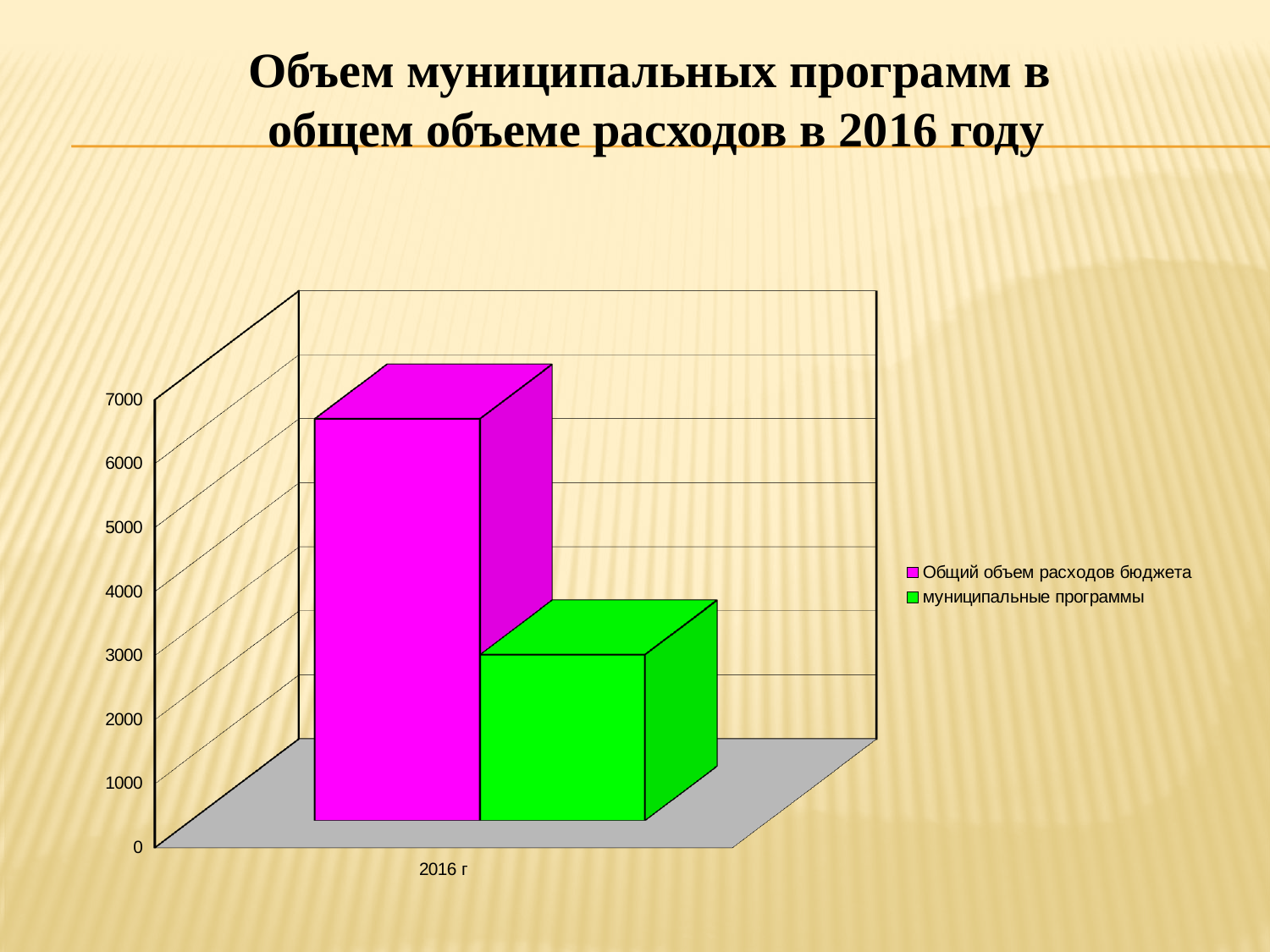
Which series has the taller bar, Общий объем расходов бюджета or муниципальные программы? Общий объем расходов бюджета What colour is the bar for муниципальные программы? green Is the value for муниципальные программы greater or less than 4000? less What kind of chart is shown on the slide? bar chart Which series has the highest value? Общий объем расходов бюджета How many categories are shown on the x axis? 1 How many series does the legend list? 2 What is the highest value shown on the vertical axis? 7000 Which series has the lowest value? муниципальные программы Is the value for муниципальные программы greater or less than 2000? greater What is the label of the category on the x axis? 2016 г Is the value for Общий объем расходов бюджета greater or less than 6000? greater